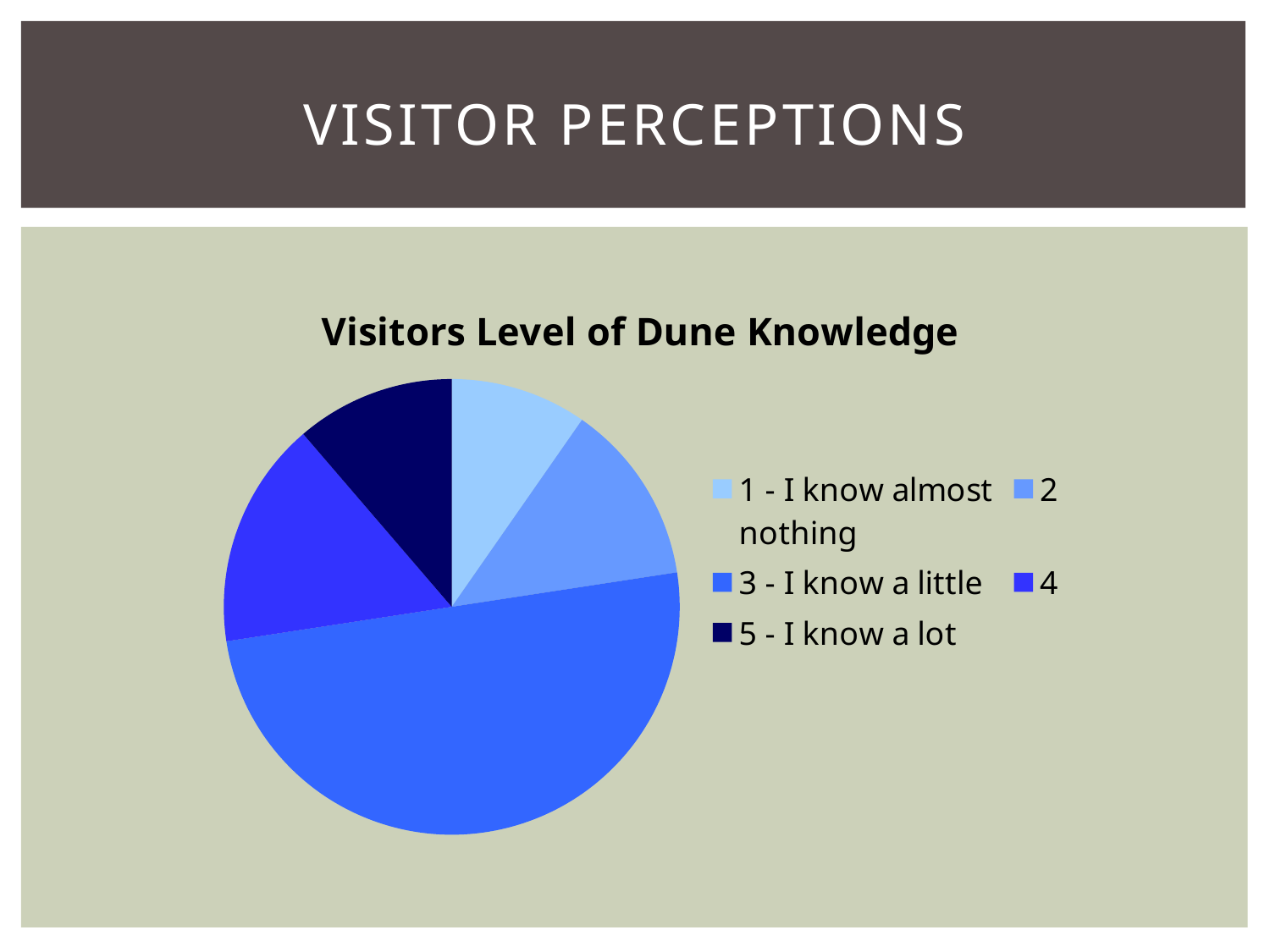
What is the legend label for the darkest (navy) slice? 5 - I know a lot Does the slice for "3 - I know a little" take up more or less than a quarter of the pie? more Which category has the largest slice of the pie? 3 - I know a little What kind of chart is shown on the slide? Pie chart Which slice is larger, "3 - I know a little" or "4"? 3 - I know a little How many slices does the pie chart have? 5 Which slice is larger, "4" or "1 - I know almost nothing"? 4 What is the title of the chart? Visitors Level of Dune Knowledge